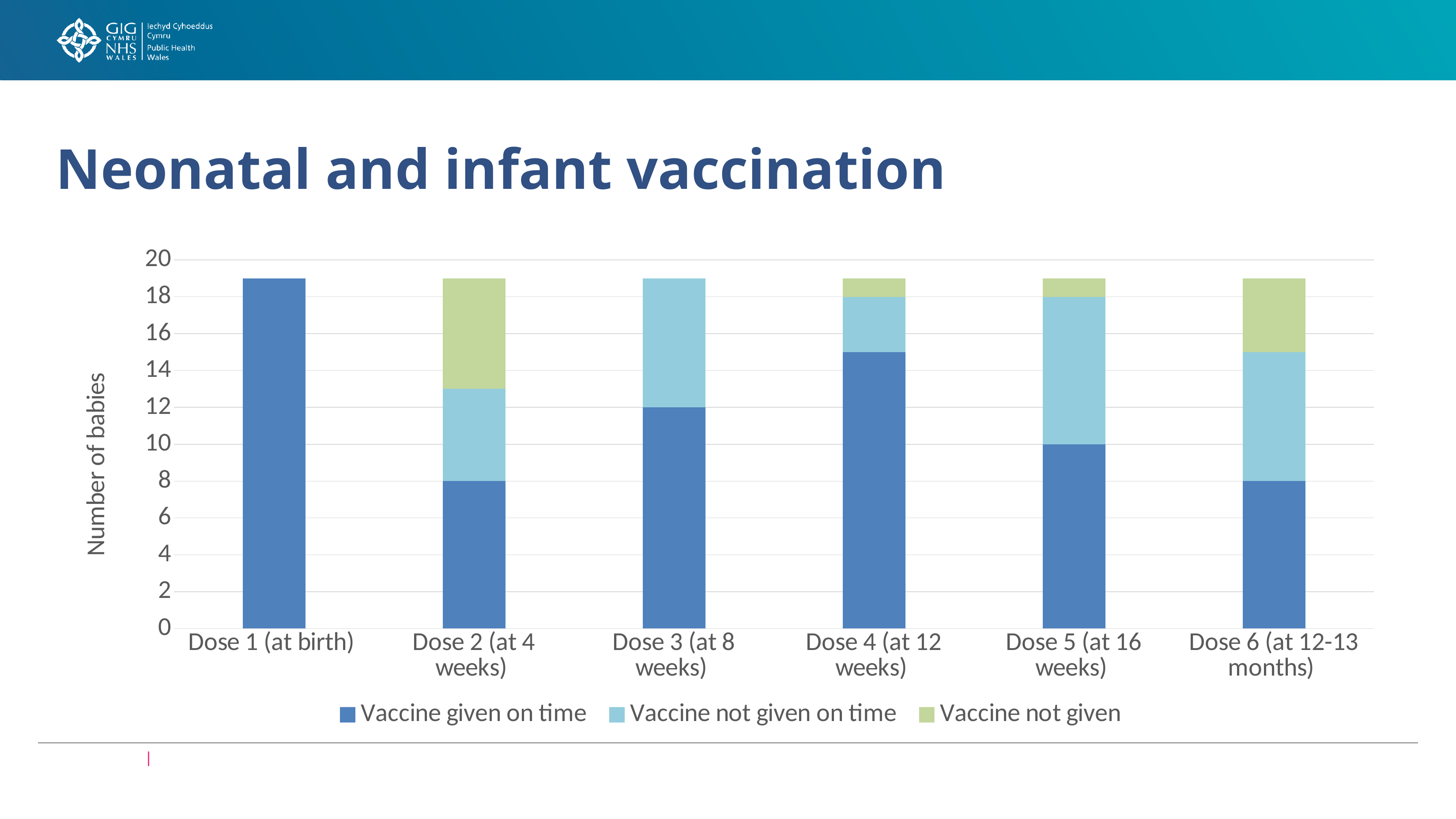
Is the 'Vaccine given on time' value for Dose 3 (at 8 weeks) larger or smaller than that for Dose 5 (at 16 weeks)? larger How many series does the legend list? 3 What kind of chart is shown on the slide? bar chart What is the value for 'Vaccine given on time' for Dose 6 (at 12-13 months)? 8 Is the 'Vaccine given on time' value for Dose 4 (at 12 weeks) greater or less than 14? greater What is the value for 'Vaccine given on time' for Dose 3 (at 8 weeks)? 12 How many dose categories are shown on the x axis? 6 Which dose has the highest value for 'Vaccine given on time'? Dose 1 (at birth) What is the label on the y axis? Number of babies What is the value for 'Vaccine given on time' for Dose 2 (at 4 weeks)? 8 Is the total height of the Dose 1 (at birth) bar greater or less than 18? greater What is the value for 'Vaccine given on time' for Dose 5 (at 16 weeks)? 10